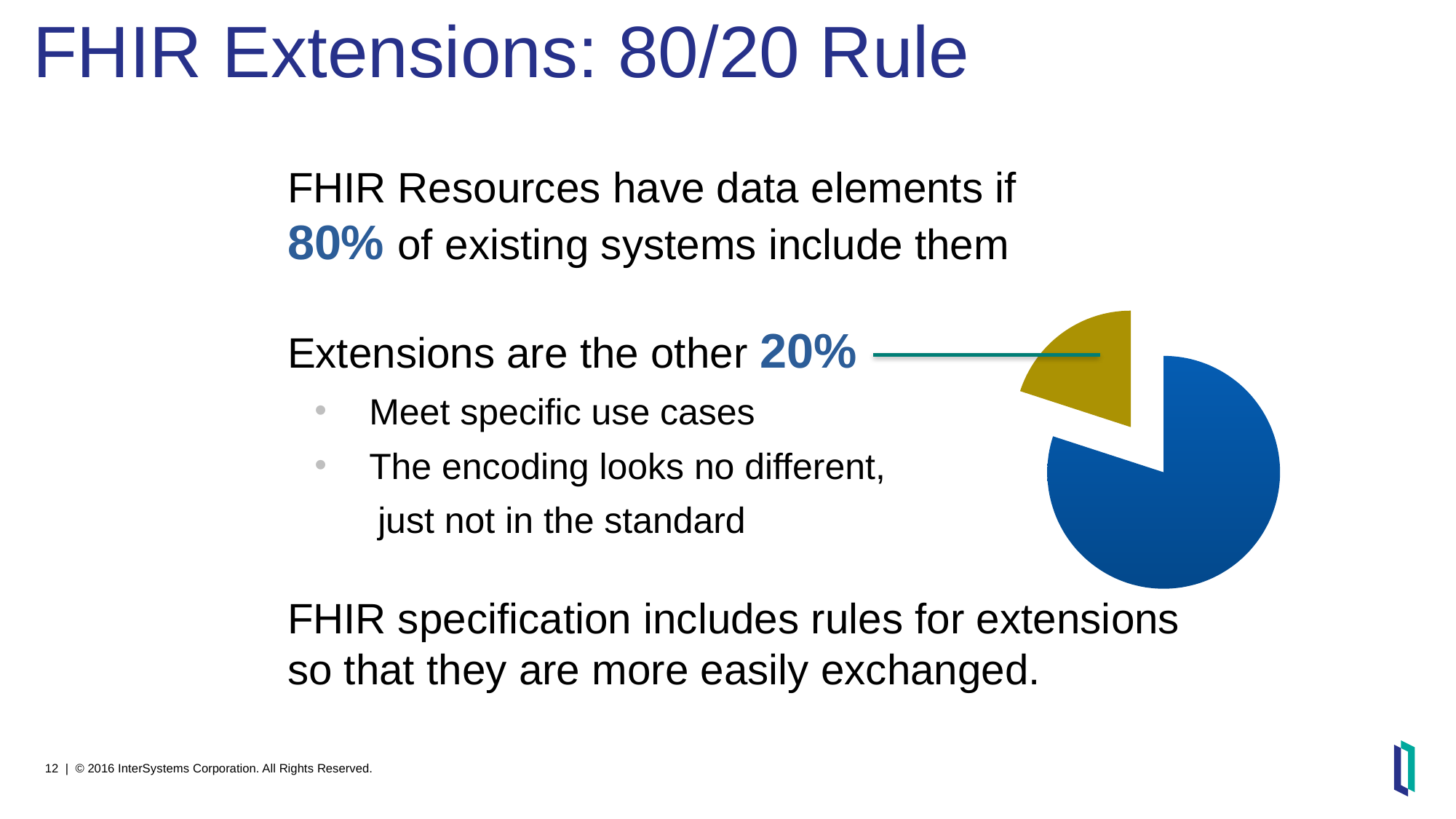
What colour is the slice representing the 80% of existing systems? blue Which slice of the pie chart is pulled out (exploded) from the rest of the pie? the gold 20% slice What share of the pie does the large blue slice represent? 80% What share of the pie does the gold slice, which the line from '20%' points to, represent? 20% How many slices does the pie chart have? 2 Which slice of the pie chart is larger, the blue slice or the gold slice? the blue slice What kind of chart is shown on the slide? pie chart Which slice of the pie chart is the smallest? the gold slice (Extensions, 20%)